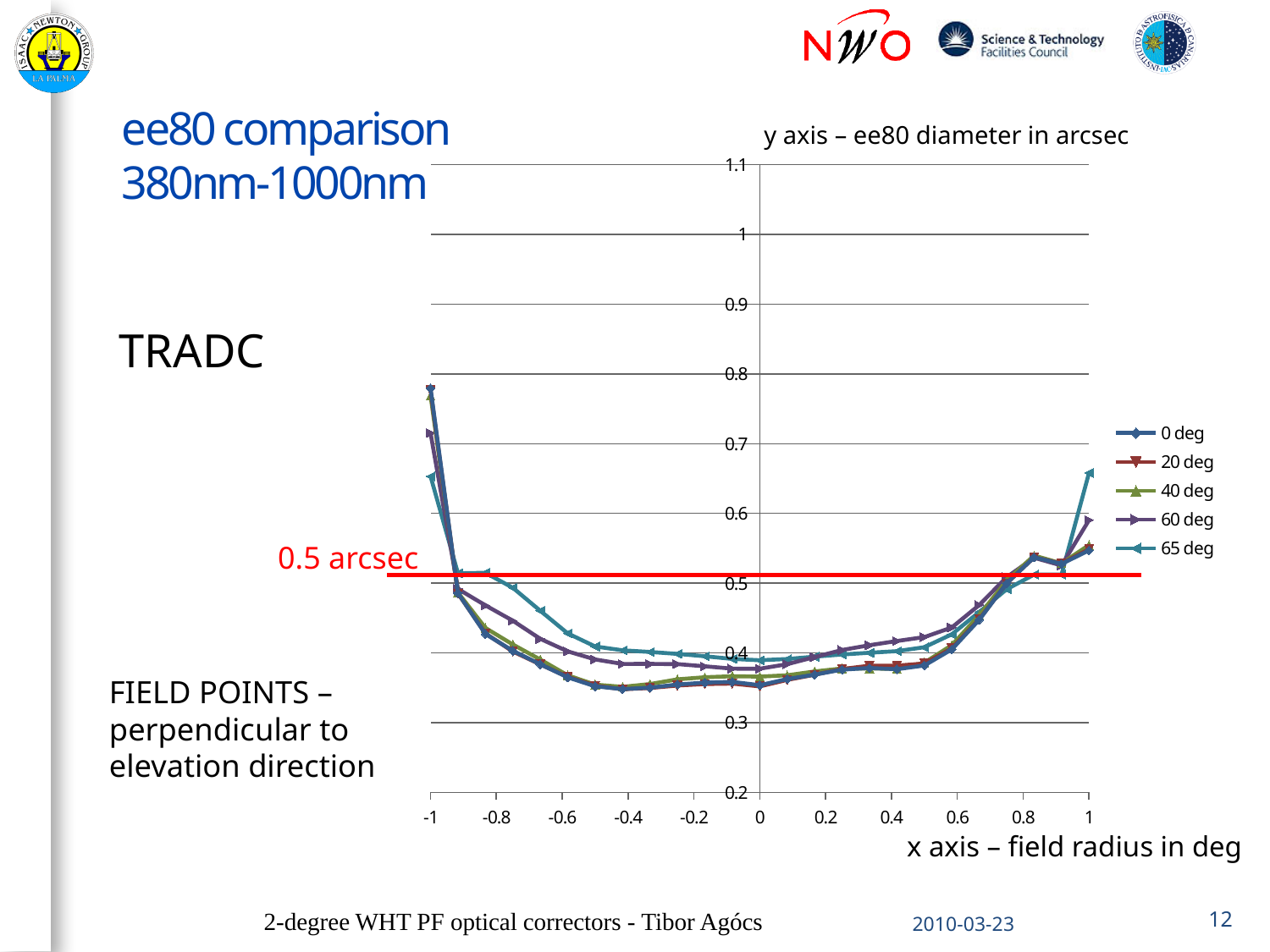
Do the values of the 0 deg series rise or fall as the field radius goes from -1 to -0.4? fall Is the value for the 0 deg series at field radius -1 greater or less than 0.7? greater What value does the red horizontal line on the chart mark? 0.5 arcsec What kind of chart is shown on the slide? line chart Is the value for the 65 deg series at field radius 1 greater or less than 0.6? greater Which series are listed in the chart legend? 0 deg, 20 deg, 40 deg, 60 deg, 65 deg How many series does the chart legend list? 5 At field radius -0.6, which series has the highest value? 65 deg At field radius -0.6, which series has the higher value, 65 deg or 0 deg? 65 deg Is the value for the 65 deg series at field radius -0.6 greater or less than 0.4? greater What is the highest tick value shown on the y axis of the chart? 1.1